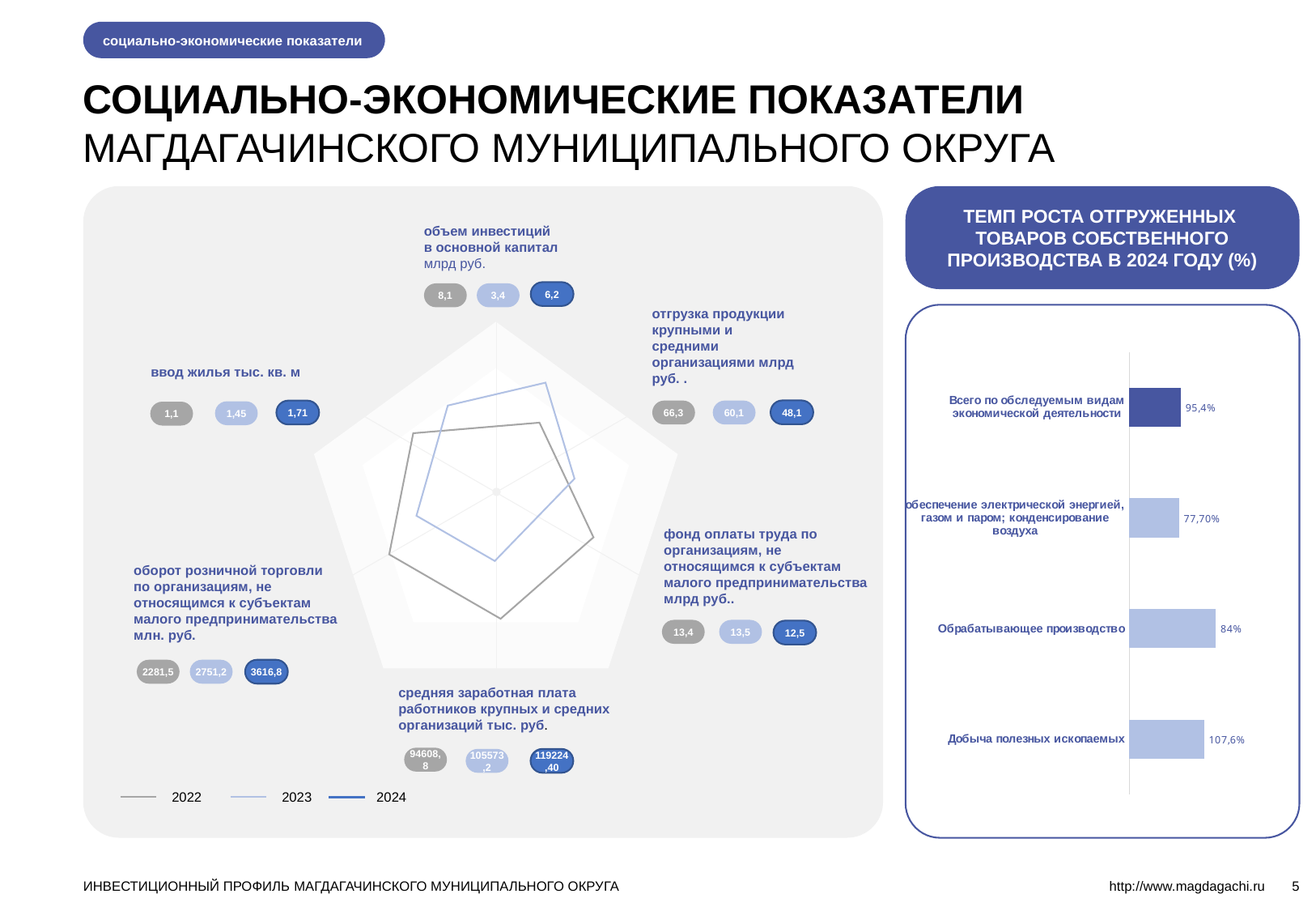
In the chart titled 'ТЕМП РОСТА ОТГРУЖЕННЫХ ТОВАРОВ СОБСТВЕННОГО ПРОИЗВОДСТВА В 2024 ГОДУ (%)', what is the value for 'Обрабатывающее производство'? 84% In the radar chart on the left, what is the difference between the 2024 and 2022 values for 'ввод жилья'? 0,61 In the chart titled 'ТЕМП РОСТА ОТГРУЖЕННЫХ ТОВАРОВ СОБСТВЕННОГО ПРОИЗВОДСТВА В 2024 ГОДУ (%)', which is larger: the value for 'Всего по обследуемым видам экономической деятельности' or for 'Обрабатывающее производство'? Всего по обследуемым видам экономической деятельности In the radar chart on the left, what is the 2024 value for 'объем инвестиций в основной капитал'? 6,2 How many series does the legend of the radar chart on the left list? 3 What kind of chart is the one titled 'ТЕМП РОСТА ОТГРУЖЕННЫХ ТОВАРОВ СОБСТВЕННОГО ПРОИЗВОДСТВА В 2024 ГОДУ (%)'? Bar chart In the chart titled 'ТЕМП РОСТА ОТГРУЖЕННЫХ ТОВАРОВ СОБСТВЕННОГО ПРОИЗВОДСТВА В 2024 ГОДУ (%)', which category has the lowest value? обеспечение электрической энергией, газом и паром; конденсирование воздуха In the chart titled 'ТЕМП РОСТА ОТГРУЖЕННЫХ ТОВАРОВ СОБСТВЕННОГО ПРОИЗВОДСТВА В 2024 ГОДУ (%)', which category has the highest value? Добыча полезных ископаемых In the radar chart on the left, what is the 2023 value for 'оборот розничной торговли по организациям, не относящимся к субъектам малого предпринимательства'? 2751,2 In the radar chart on the left, what is the 2022 value for 'отгрузка продукции крупными и средними организациями'? 66,3 In the chart titled 'ТЕМП РОСТА ОТГРУЖЕННЫХ ТОВАРОВ СОБСТВЕННОГО ПРОИЗВОДСТВА В 2024 ГОДУ (%)', how many categories are shown? 4 In the chart titled 'ТЕМП РОСТА ОТГРУЖЕННЫХ ТОВАРОВ СОБСТВЕННОГО ПРОИЗВОДСТВА В 2024 ГОДУ (%)', what is the value for 'Добыча полезных ископаемых'? 107,6%